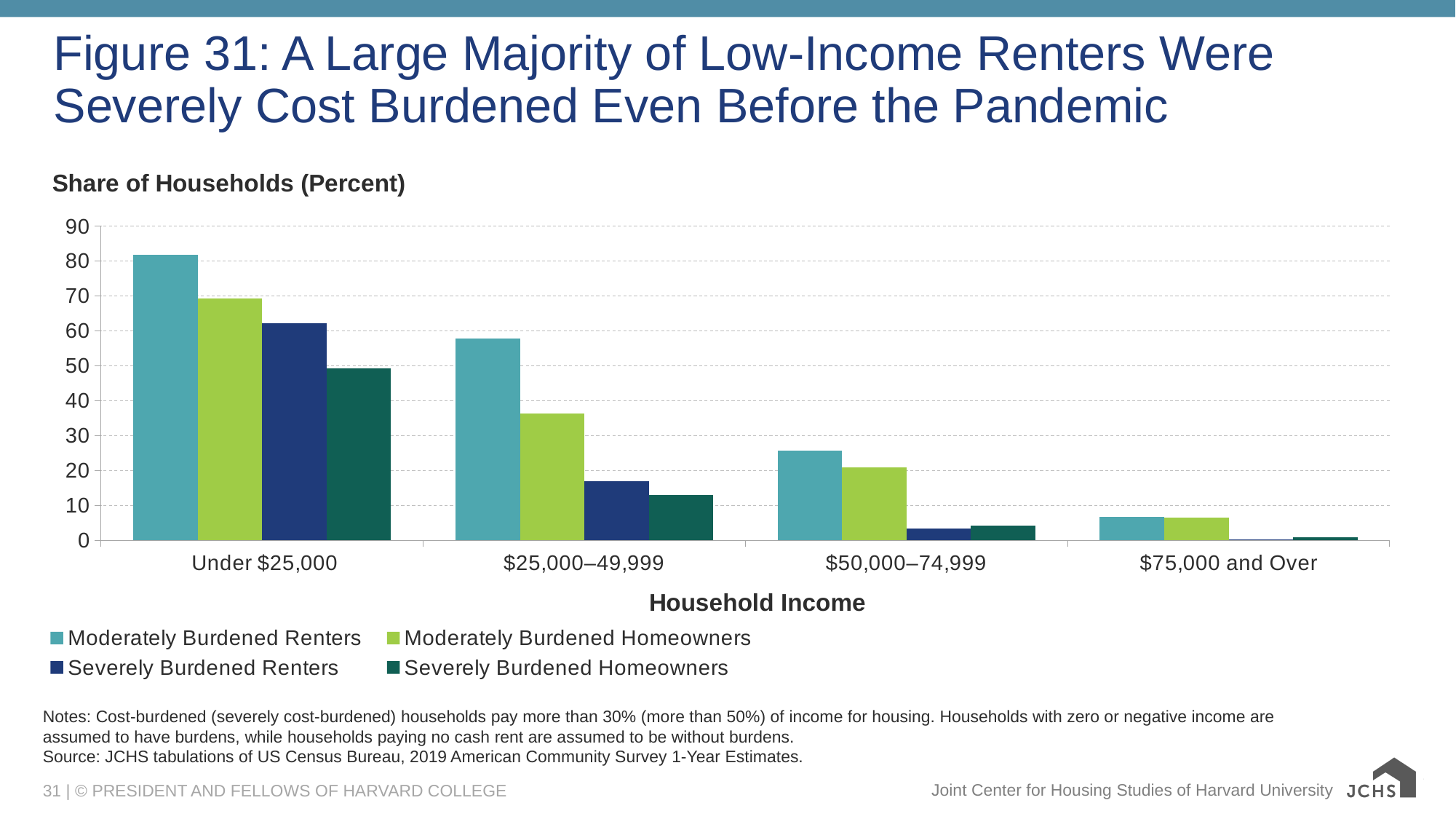
Which household income category has the lowest value for Severely Burdened Renters? $75,000 and Over What is the label of the y axis of the chart? Share of Households (Percent) What kind of chart is shown on the slide? bar chart How many series does the legend list? 4 Is the value for Moderately Burdened Homeowners in the $25,000–49,999 category greater or less than 30? greater Which household income category has the highest value for Moderately Burdened Renters? Under $25,000 How many household income categories are shown on the x axis? 4 How do the values for Moderately Burdened Renters change as household income increases along the x axis? They fall Is the value for Moderately Burdened Renters in the Under $25,000 category greater or less than 80? greater Which is larger in the $25,000–49,999 category: Moderately Burdened Renters or Severely Burdened Renters? Moderately Burdened Renters Is the value for Severely Burdened Renters in the $50,000–74,999 category greater or less than 10? less